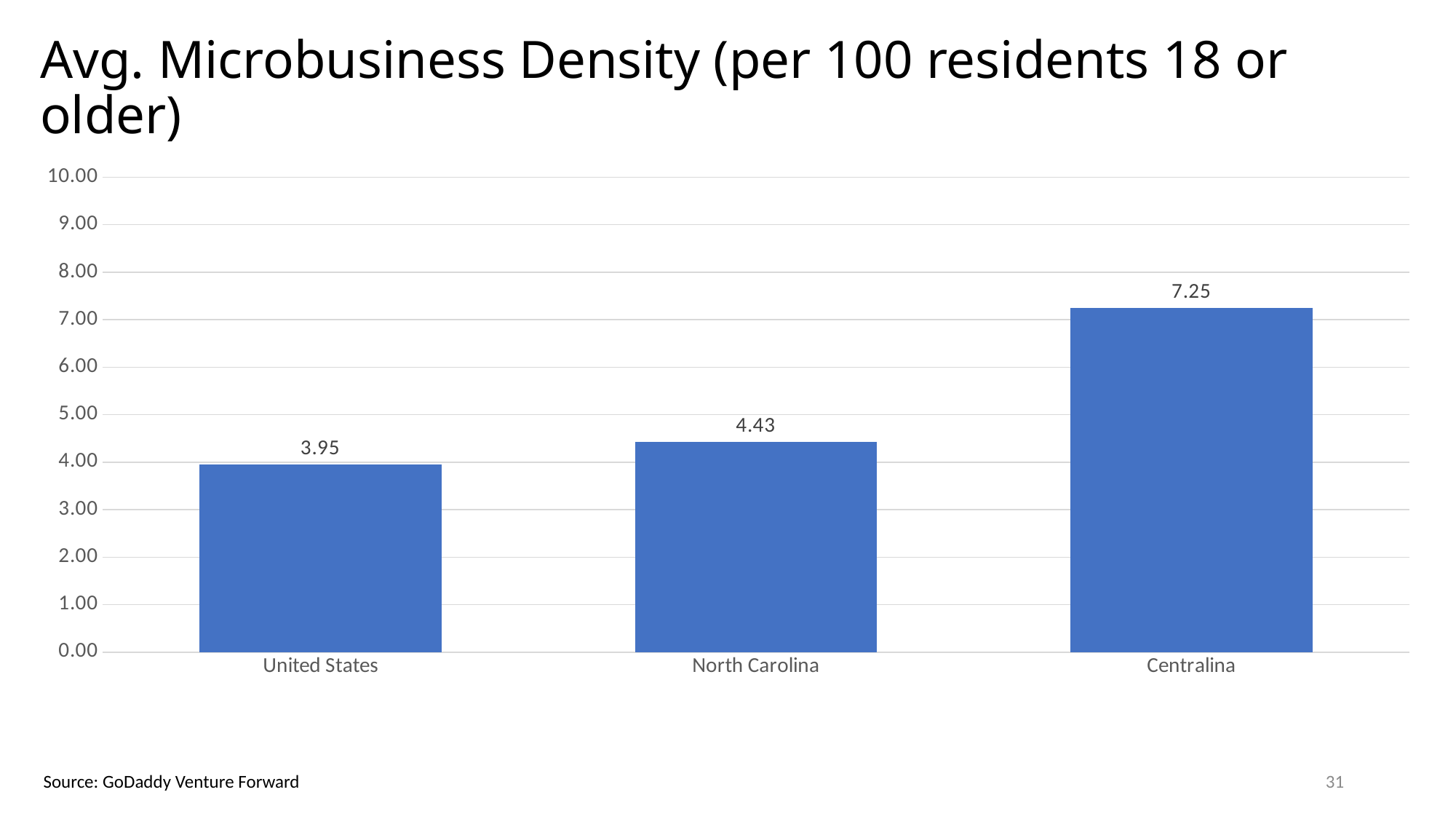
Which is larger, the value for North Carolina or the value for United States? North Carolina What is the difference between the North Carolina value and the United States value? 0.48 What kind of chart is shown on the slide? Bar chart Which category has the highest average microbusiness density? Centralina What is the average microbusiness density for Centralina? 7.25 What is the average microbusiness density for North Carolina? 4.43 What is the average microbusiness density for the United States? 3.95 What is the difference between the Centralina value and the United States value? 3.30 Is the value for Centralina greater or less than 7.00? greater Which category has the lowest average microbusiness density? United States Do the values rise or fall from left to right across the categories? Rise How many categories are shown on the chart? 3